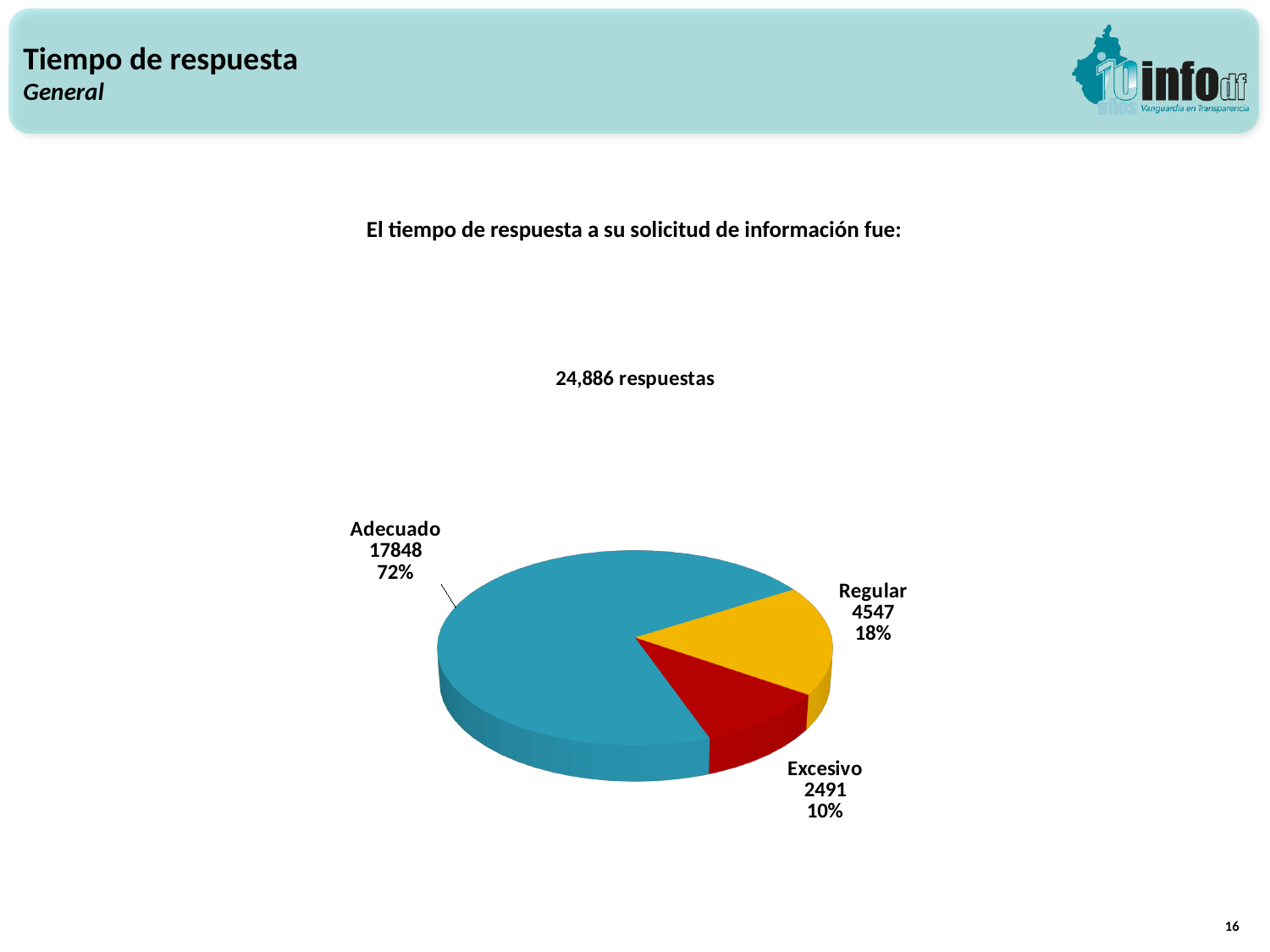
How many responses does the Adecuado slice represent? 17848 How many responses does the Excesivo slice represent? 2491 Which category has the largest slice of the pie? Adecuado Which has more responses, Regular or Excesivo? Regular Which category has the smallest slice of the pie? Excesivo What share of the pie does the Excesivo slice represent? 10% How many responses does the Regular slice represent? 4547 How many categories are shown in the pie chart? 3 What kind of chart is shown on the slide? pie chart What total number of responses is stated above the chart? 24,886 respuestas What is the difference in responses between Regular and Excesivo? 2056 What share of the pie does the Regular slice represent? 18%